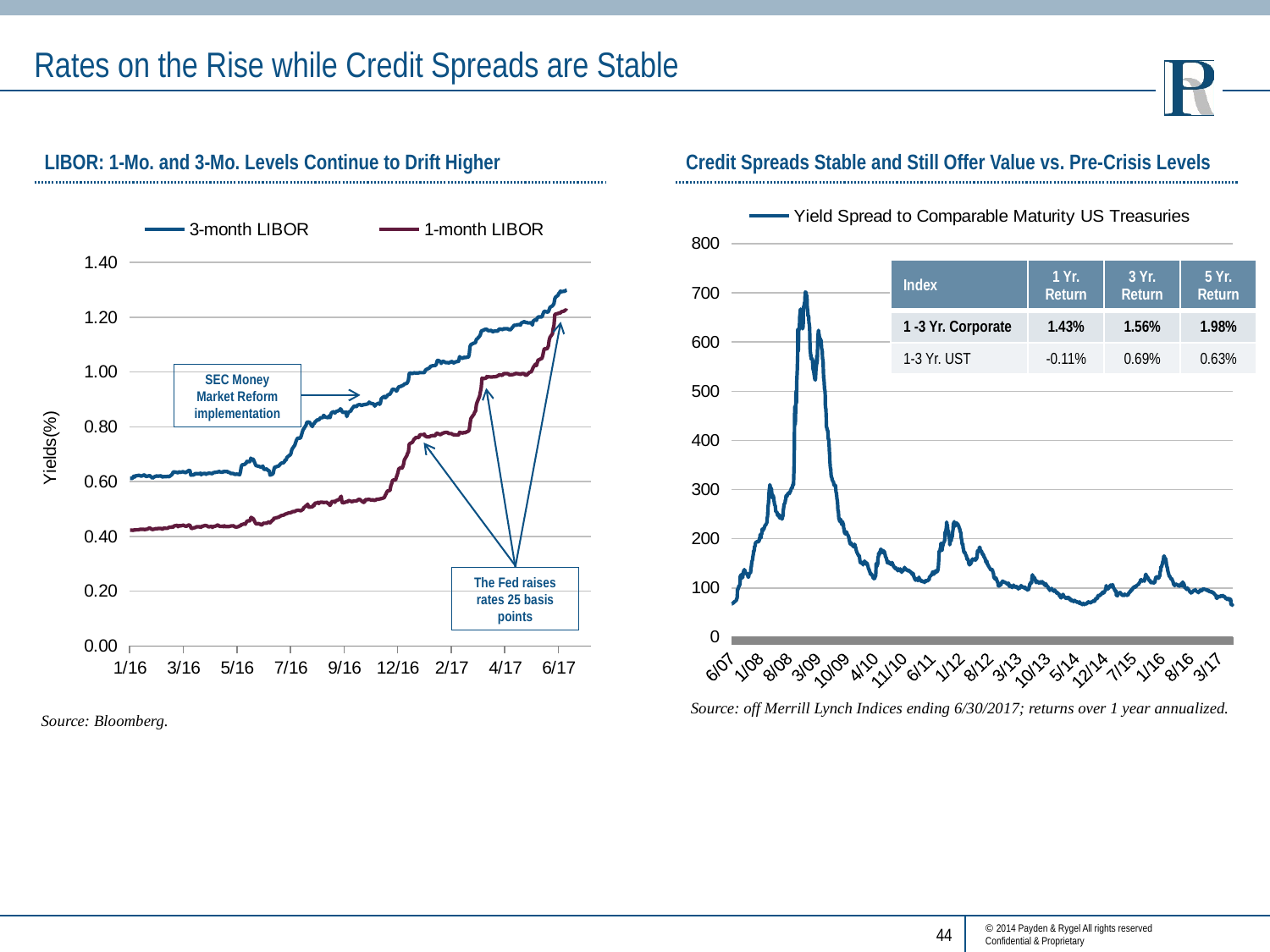
In the left LIBOR chart, which series is higher at 6/17, 3-month LIBOR or 1-month LIBOR? 3-month LIBOR In the right credit spreads chart, is the peak value of the yield spread greater or less than 600? greater In the table on the right credit spreads chart, what is the difference between the 3 Yr. Return of 1-3 Yr. Corporate and 1-3 Yr. UST? 0.87% In the table on the right credit spreads chart, what is the 5 Yr. Return for 1-3 Yr. Corporate? 1.98% In the right credit spreads chart, is the yield spread at 3/17 greater or less than 100? less How many series does the legend of the right chart titled 'Credit Spreads Stable and Still Offer Value vs. Pre-Crisis Levels' list? 1 In the left LIBOR chart, do the 3-month LIBOR values rise or fall from 1/16 to 6/17? rise In the left LIBOR chart, is the 3-month LIBOR value at 1/16 greater or less than 0.80? less What is the y-axis label of the left LIBOR chart? Yields(%) How many series does the legend of the left LIBOR chart list? 2 What kind of chart is the left chart titled 'LIBOR: 1-Mo. and 3-Mo. Levels Continue to Drift Higher'? line chart